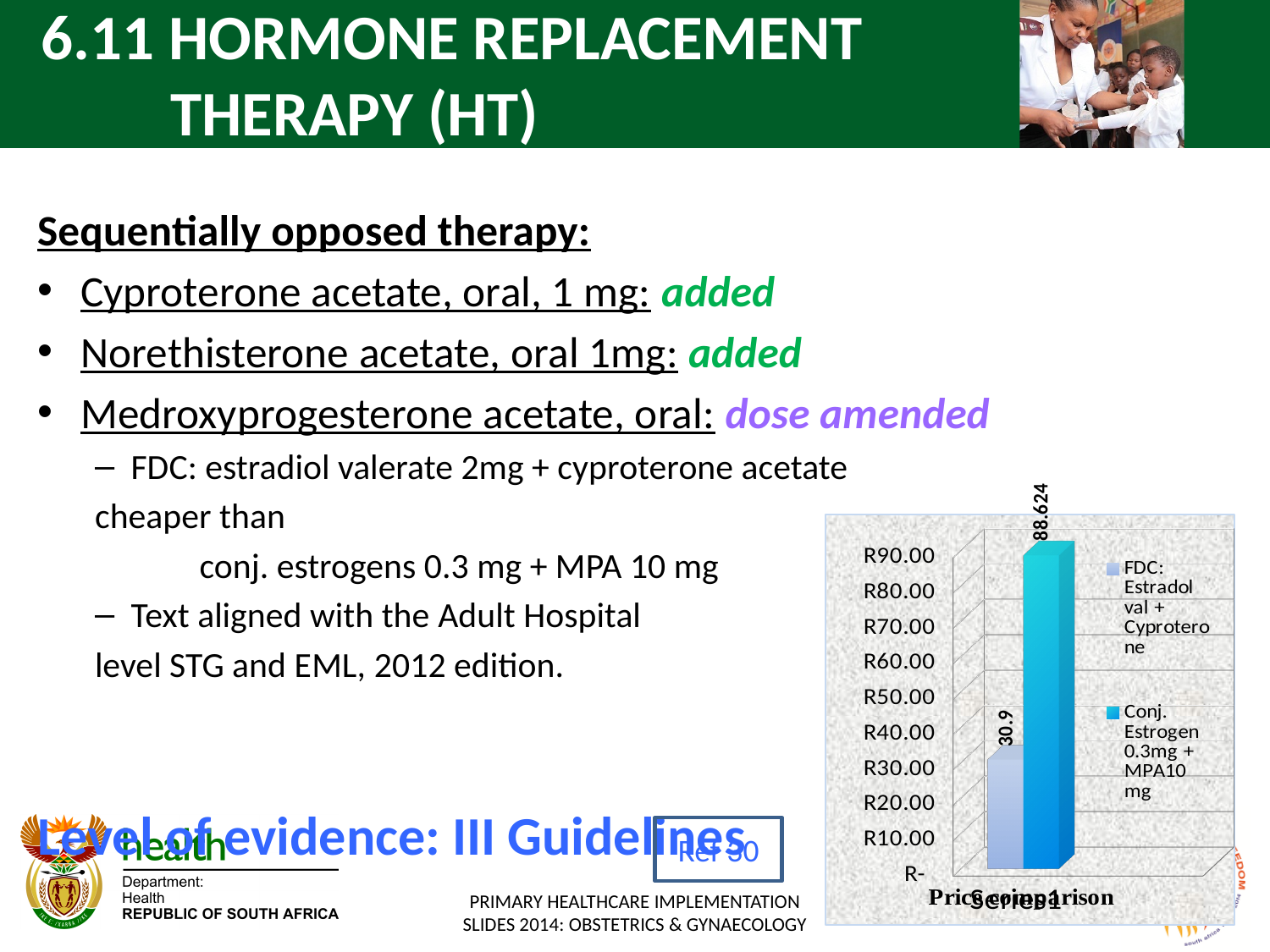
What kind of chart is shown on the slide? bar chart Is the value for Conj. Estrogen 0.3mg + MPA10 mg greater or less than R80.00? greater What is the highest value labelled on the chart's vertical axis? R90.00 Which series has the highest value in the chart? Conj. Estrogen 0.3mg + MPA10 mg Which series has the higher value, FDC: Estradol val + Cyproterone or Conj. Estrogen 0.3mg + MPA10 mg? Conj. Estrogen 0.3mg + MPA10 mg Is the value for FDC: Estradol val + Cyproterone greater or less than R40.00? less What is the value shown for the Conj. Estrogen 0.3mg + MPA10 mg bar? 88.624 How many series does the chart legend list? 2 Which series has the lowest value in the chart? FDC: Estradol val + Cyproterone What is the difference between the Conj. Estrogen 0.3mg + MPA10 mg value and the FDC: Estradol val + Cyproterone value? 57.724 How many bars are plotted in the chart? 2 What is the value shown for the FDC: Estradol val + Cyproterone bar? 30.9